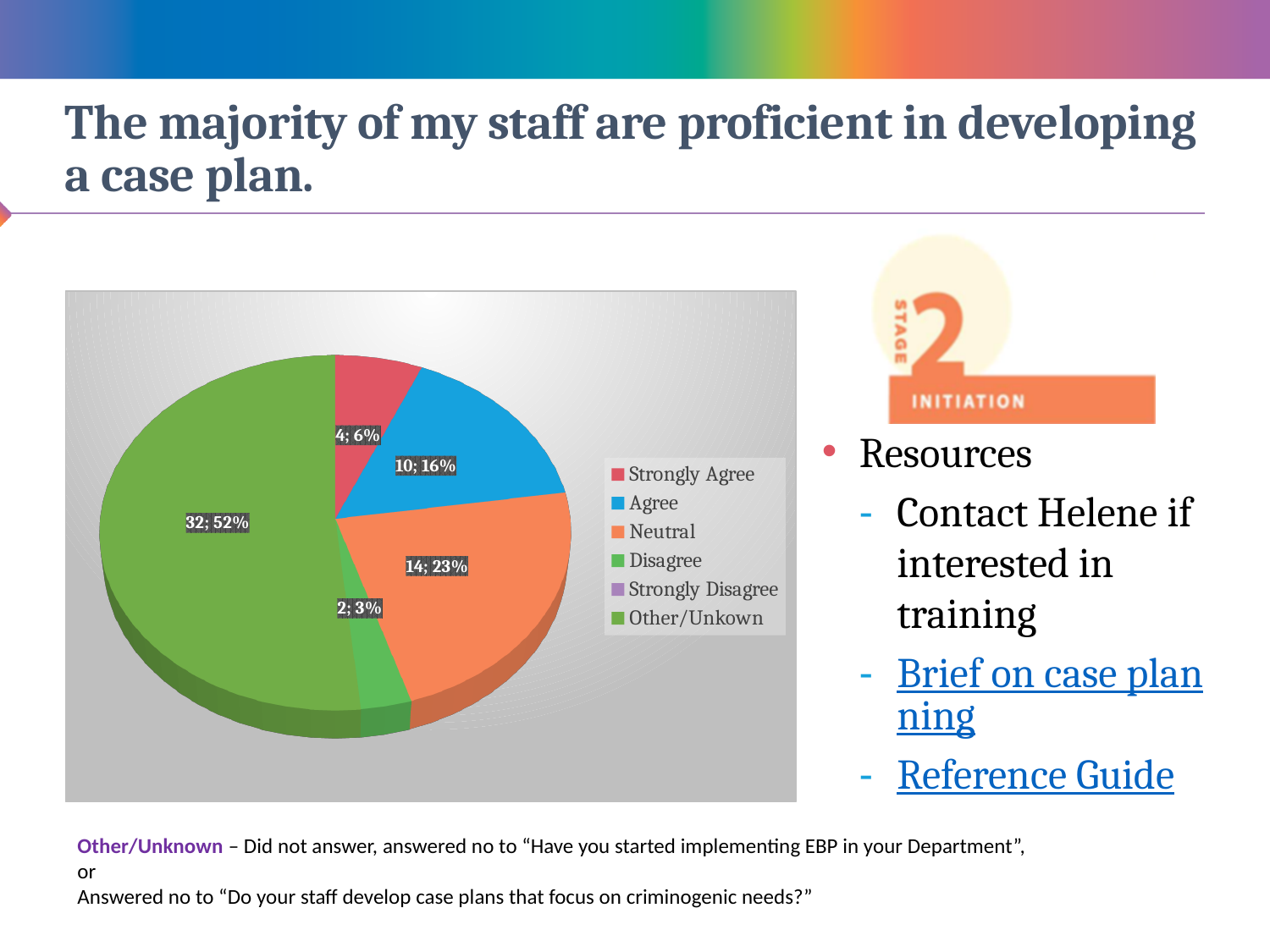
What colour is the Neutral slice in the pie chart? orange How many respondents answered Strongly Agree? 4 What is the difference between the number of Neutral responses and the number of Agree responses? 4 What percentage of the pie is the Other/Unkown slice? 52% Which labelled slice of the pie is the smallest? Disagree What percentage of the pie is the Disagree slice? 3% Which is larger, the Agree slice or the Strongly Agree slice? Agree What kind of chart is shown on the slide? pie chart How many entries does the legend list? 6 How many respondents answered Neutral? 14 Which category has the largest slice of the pie? Other/Unkown What percentage of the pie is the Agree slice? 16%